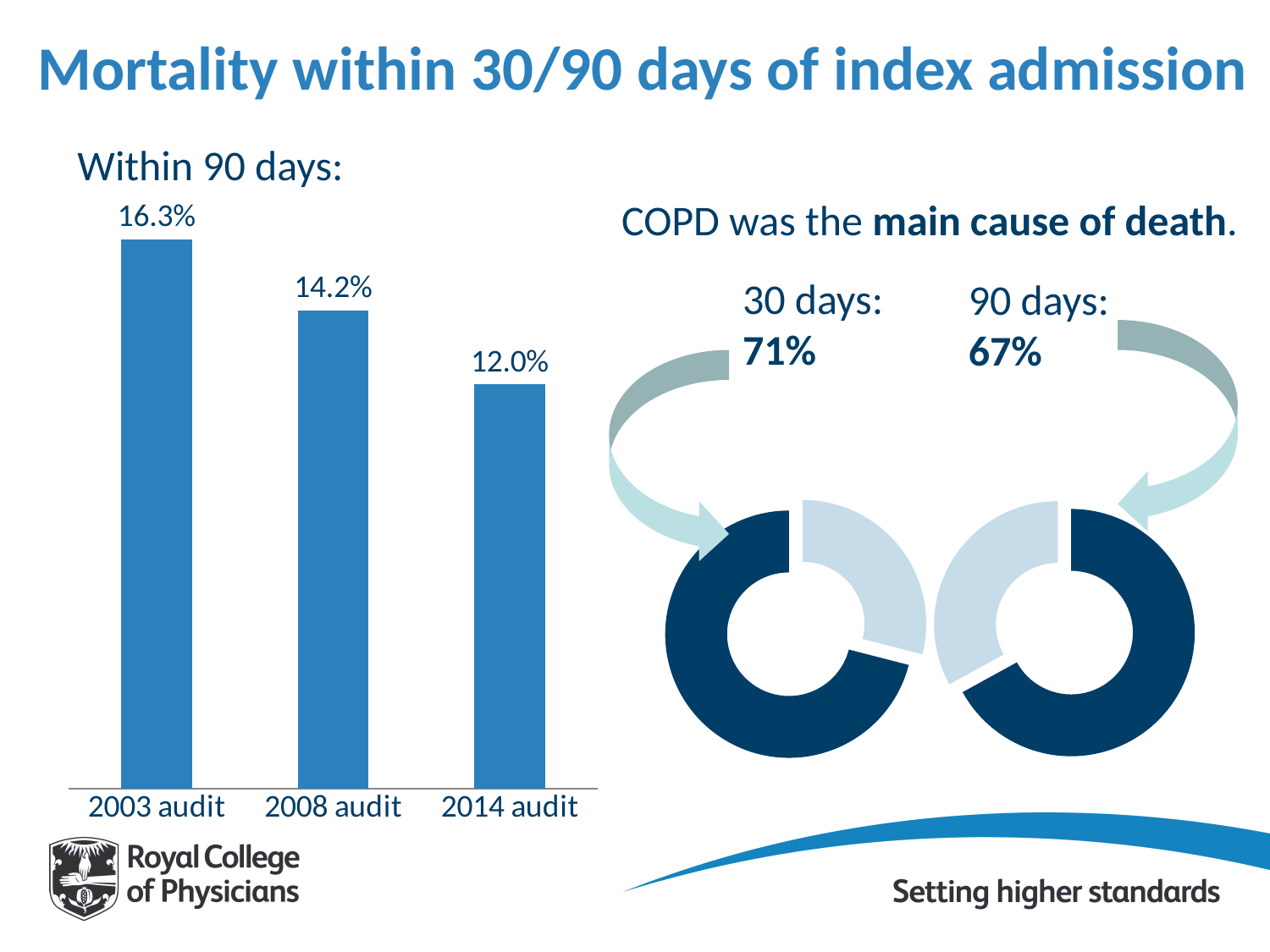
In the 'Within 90 days' bar chart, what is the value for the 2003 audit? 16.3% In the donut charts on the right, what share of deaths within 90 days was COPD the main cause? 67% In the 'Within 90 days' bar chart, which audit has the lowest mortality? 2014 audit In the 'Within 90 days' bar chart, what is the value for the 2014 audit? 12.0% In the 'Within 90 days' bar chart, do the values rise or fall from the 2003 audit to the 2014 audit? Fall In the 'Within 90 days' bar chart, which is larger, the 2008 audit value or the 2014 audit value? 2008 audit What kind of chart is the 'Within 90 days' chart on the left? Bar chart In the donut charts on the right, what share of deaths within 30 days was COPD the main cause? 71% In the 'Within 90 days' bar chart, which audit has the highest mortality? 2003 audit In the 'Within 90 days' bar chart, what is the difference between the 2003 audit and the 2014 audit values? 4.3% How many audits are shown in the 'Within 90 days' bar chart? 3 In the 'Within 90 days' bar chart, what is the value for the 2008 audit? 14.2%